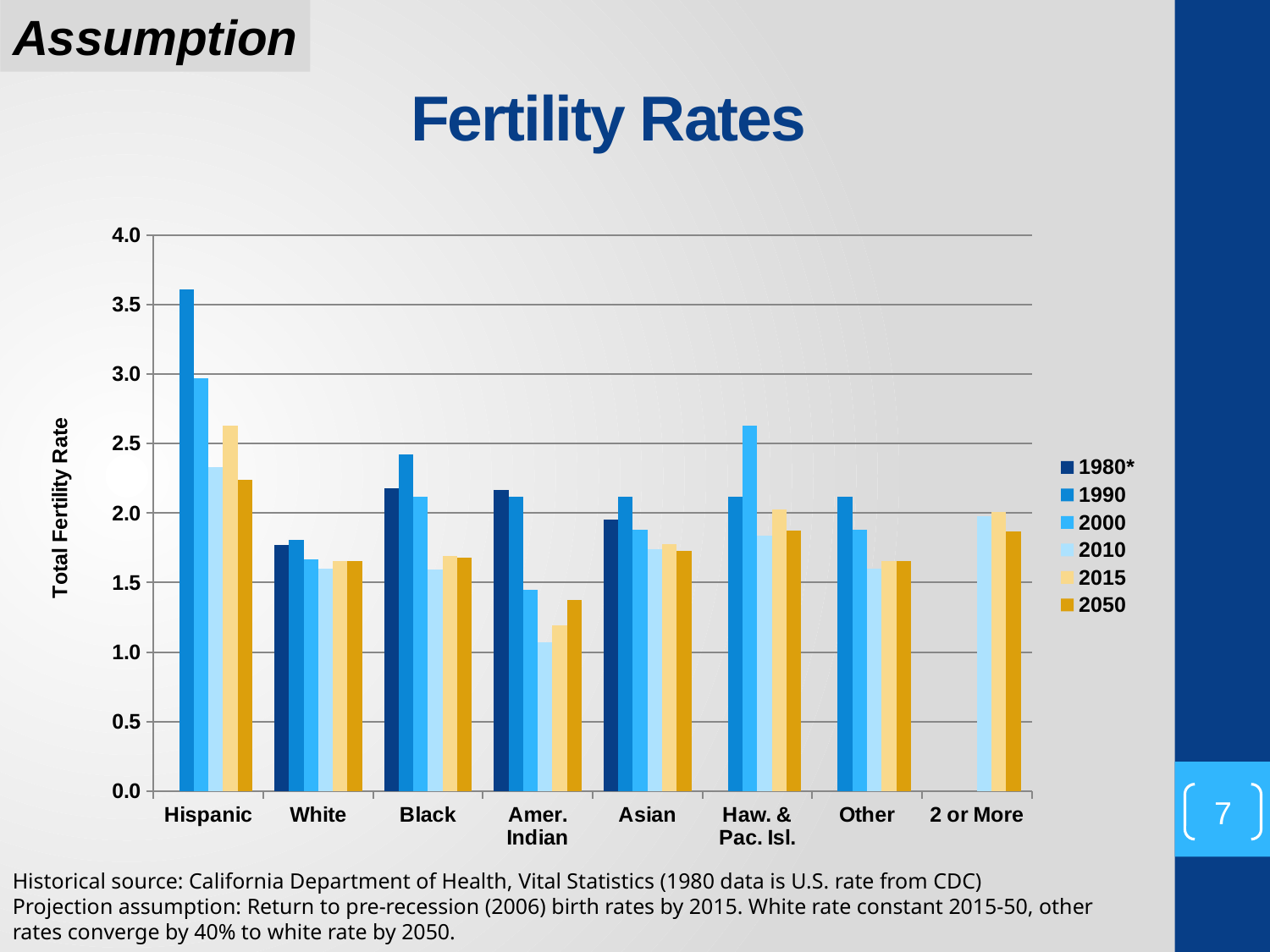
Is the 2000 value for Haw. & Pac. Isl. greater or less than 2.5? greater Is the 1990 value for Hispanic greater or less than 3.0? greater Is the 2010 value for Amer. Indian greater or less than 1.5? less How many categories are shown along the x axis of the chart? 8 For Hispanic, do the values fall or rise from 1990 to 2010? fall How many series does the chart's legend list? 6 What kind of chart is shown on the slide? bar chart Which category has the lowest bar in the chart? Amer. Indian Which is larger, the 2000 value for Black or the 2000 value for Asian? Black Which category has the highest bar in the chart? Hispanic What is the label on the chart's vertical axis? Total Fertility Rate